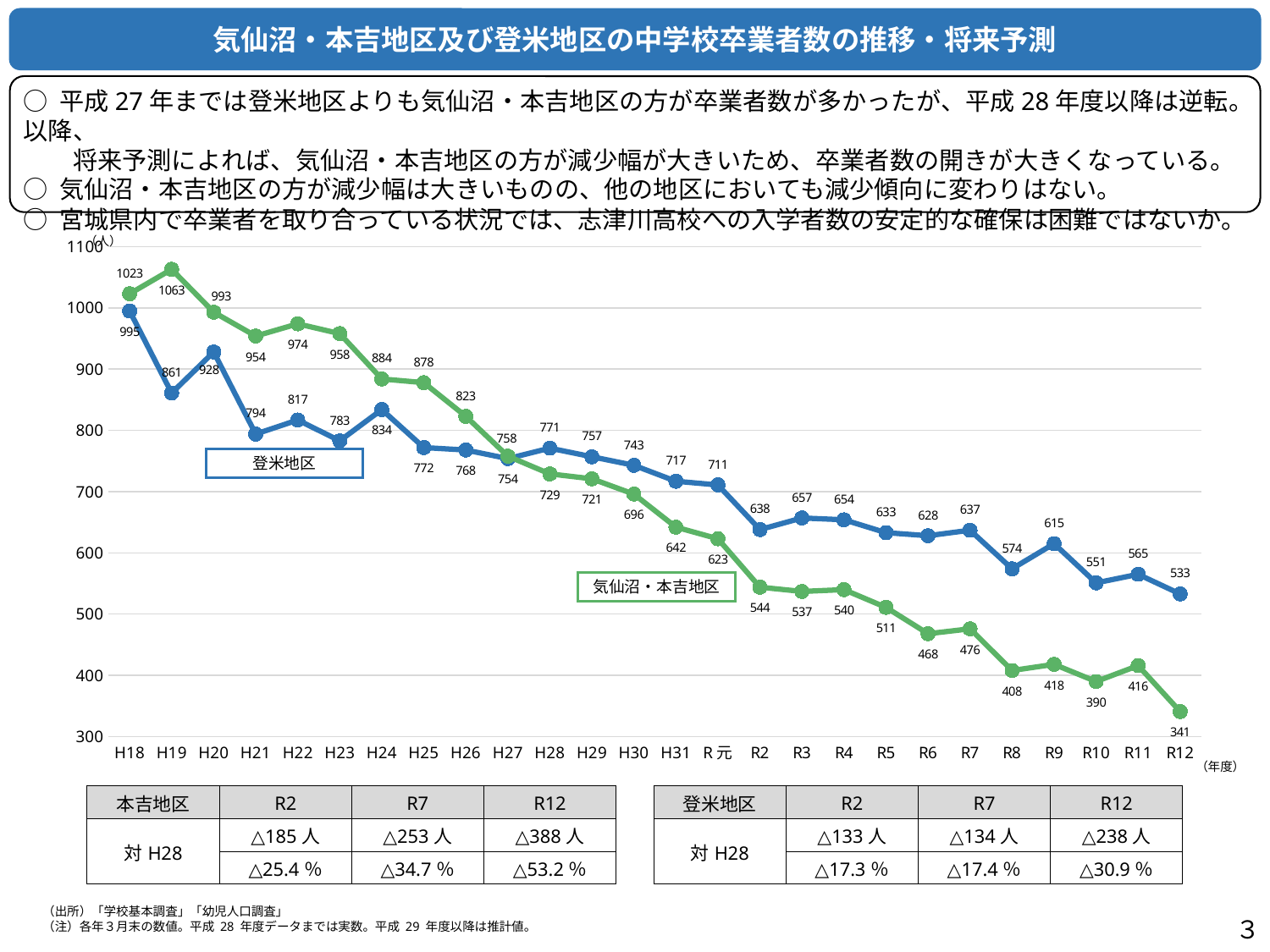
Do the values for 気仙沼・本吉地区 generally rise or fall from H18 to R12? fall What is the value for 気仙沼・本吉地区 in R12? 341 What kind of chart is shown on the slide? line chart What is the value for 登米地区 in R12? 533 Which series has the larger value in H18, 登米地区 or 気仙沼・本吉地区? 気仙沼・本吉地区 In which year does 登米地区 reach its lowest value? R12 What is the value for 気仙沼・本吉地区 in H19? 1063 How many series are plotted in the chart? 2 In which year does 気仙沼・本吉地区 reach its highest value? H19 What is the difference between 登米地区 and 気仙沼・本吉地区 in R12? 192 Which series has the larger value in R2, 登米地区 or 気仙沼・本吉地区? 登米地区 How many years are plotted along the x axis? 26